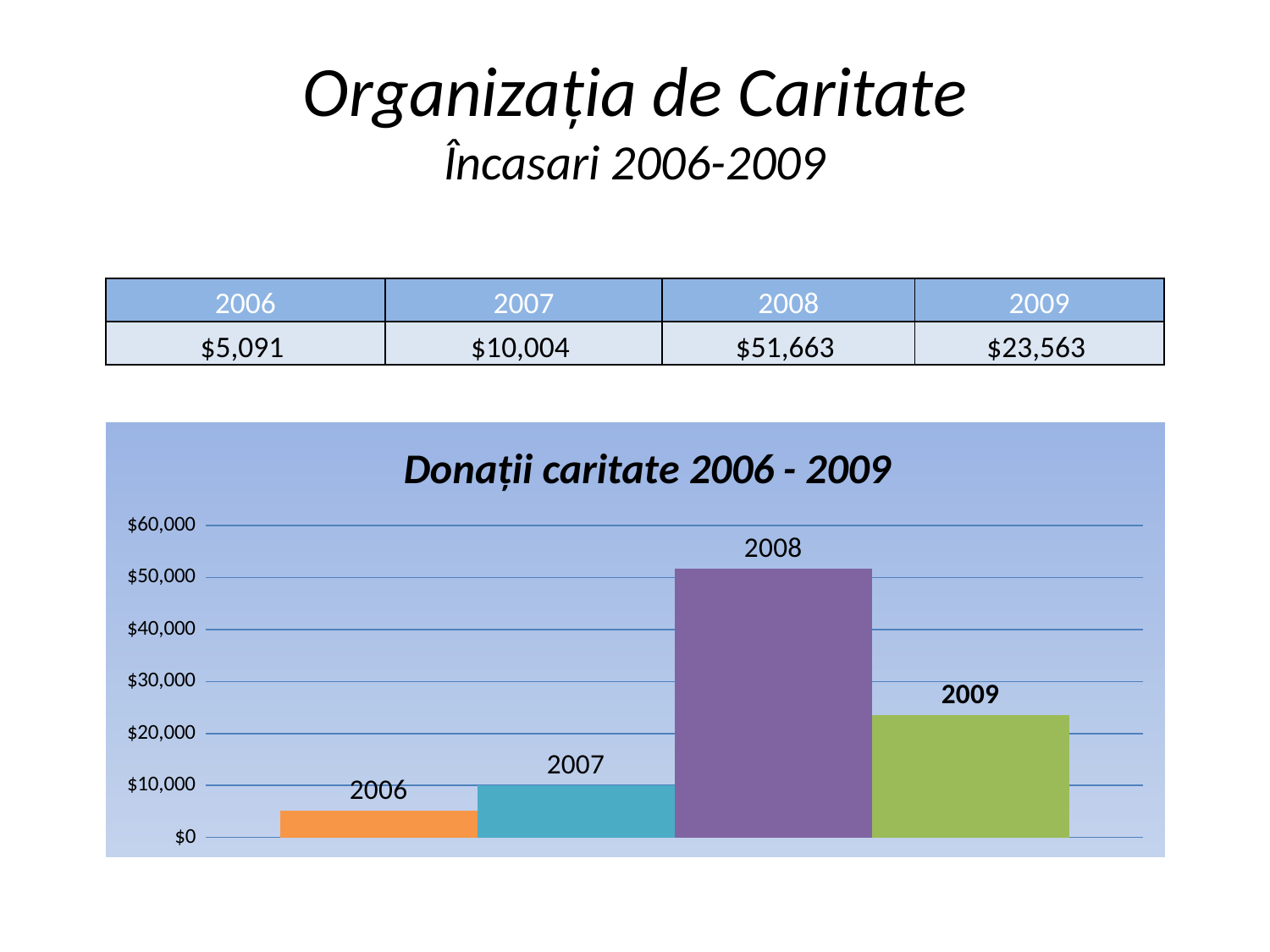
What is the value for 2008? $51,663 How many bars are plotted in the chart? 4 Which is larger, the value for 2007 or the value for 2009? 2009 Which year has the highest donations in the chart? 2008 Which year has the lowest donations in the chart? 2006 Do the values rise or fall from 2006 to 2008? rise What is the value for 2006? $5,091 Is the value for 2008 greater or less than $50,000? greater What is the difference between the values for 2008 and 2009? $28,100 What is the value for 2009? $23,563 What is the title of the chart? Donații caritate 2006 - 2009 What type of chart is shown on the slide? bar chart